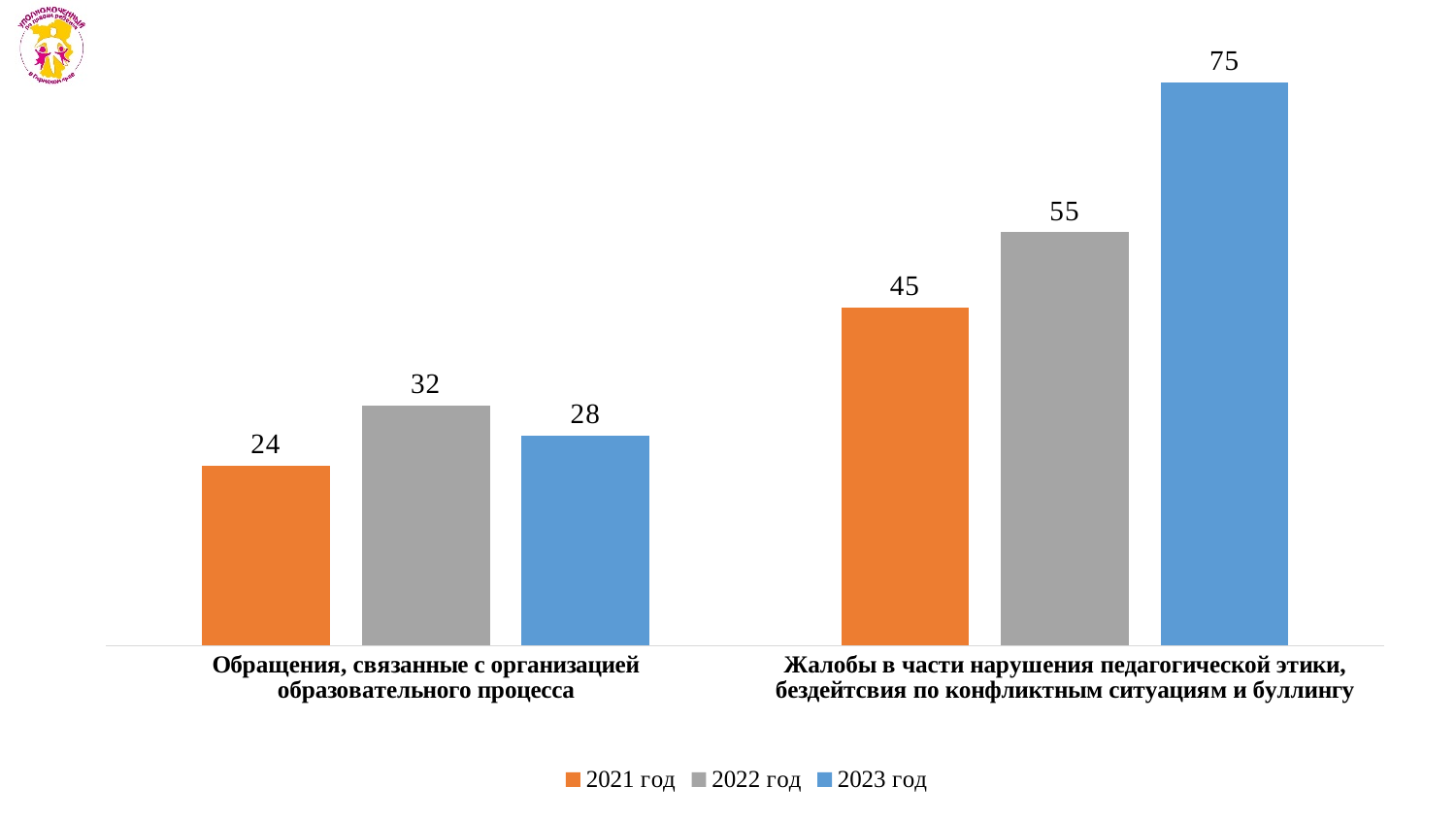
Which colour represents 2023 год in the legend? Blue What is the value for 2023 год in the category 'Жалобы в части нарушения педагогической этики, бездейтсвия по конфликтным ситуациям и буллингу'? 75 What kind of chart is shown on the slide? Bar chart What is the difference between the 2022 год and 2023 год values in the category 'Обращения, связанные с организацией образовательного процесса'? 4 What is the value for 2022 год in the category 'Обращения, связанные с организацией образовательного процесса'? 32 How many categories are shown on the x axis? 2 How many series does the legend list? 3 Which is larger: the 2022 год value for 'Обращения, связанные с организацией образовательного процесса' or the 2021 год value for 'Жалобы в части нарушения педагогической этики, бездейтсвия по конфликтным ситуациям и буллингу'? 2021 год value for 'Жалобы в части нарушения педагогической этики, бездейтсвия по конфликтным ситуациям и буллингу' What is the value for 2021 год in the category 'Обращения, связанные с организацией образовательного процесса'? 24 Which year has the lowest value in the category 'Обращения, связанные с организацией образовательного процесса'? 2021 год Which year has the highest value in the category 'Жалобы в части нарушения педагогической этики, бездейтсвия по конфликтным ситуациям и буллингу'? 2023 год What is the difference between the 2023 год and 2021 год values in the category 'Жалобы в части нарушения педагогической этики, бездейтсвия по конфликтным ситуациям и буллингу'? 30